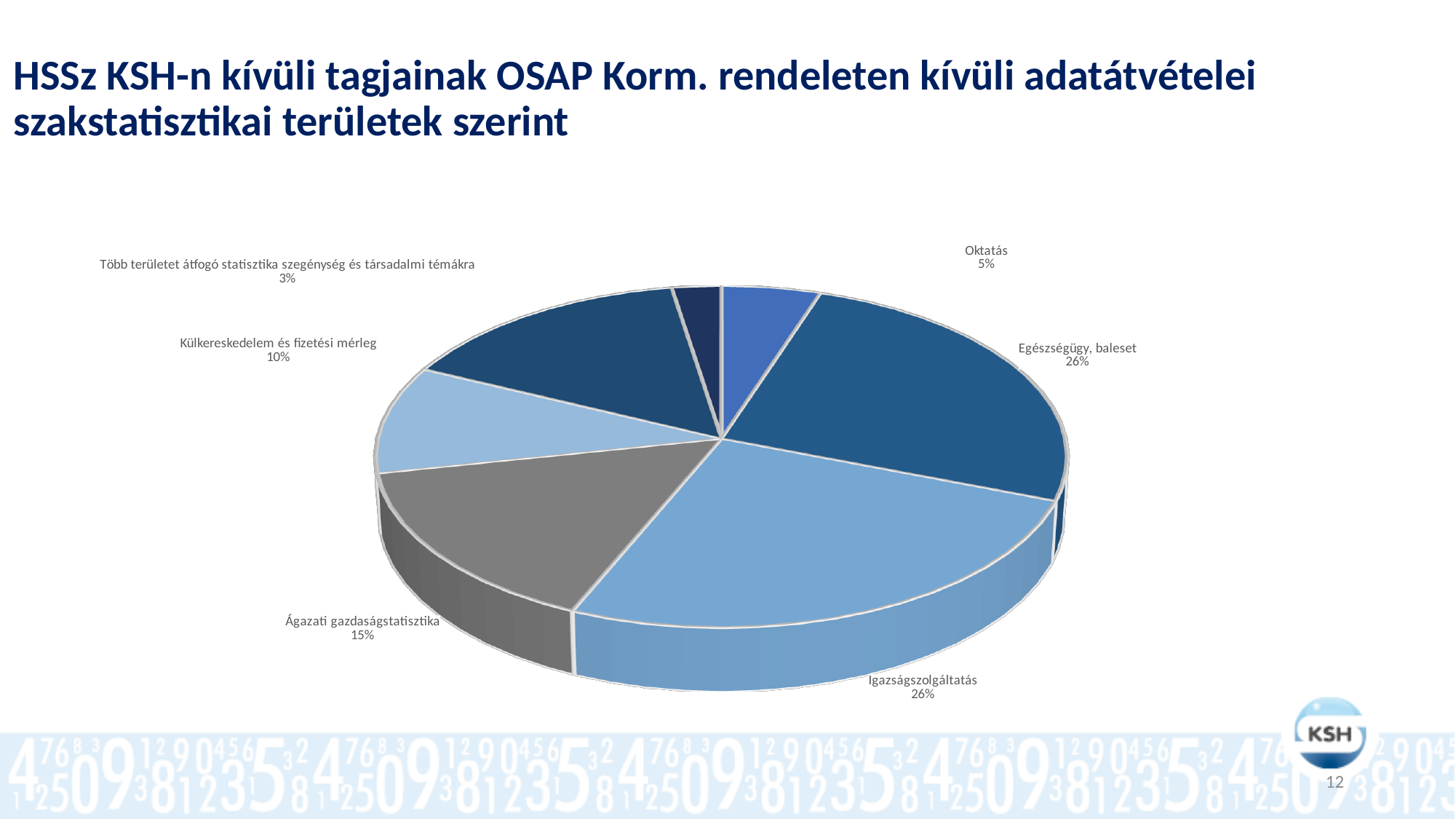
What percentage is shown for Igazságszolgáltatás? 26% What percentage is shown for Külkereskedelem és fizetési mérleg? 10% What is the title of the slide containing the pie chart? HSSz KSH-n kívüli tagjainak OSAP Korm. rendeleten kívüli adatátvételei szakstatisztikai területek szerint What share of the pie does Oktatás represent? 5% What kind of chart is shown on the slide? pie chart Which labelled category has the smallest share of the pie? Több területet átfogó statisztika szegénység és társadalmi témákra How many slices does the pie chart have? 7 What percentage is shown for Egészségügy, baleset? 26% Which is larger, the share for Ágazati gazdaságstatisztika or the share for Külkereskedelem és fizetési mérleg? Ágazati gazdaságstatisztika What percentage is shown for Ágazati gazdaságstatisztika? 15% What is the difference in percentage points between Egészségügy, baleset and Oktatás? 21 What is the difference in percentage points between Ágazati gazdaságstatisztika and Külkereskedelem és fizetési mérleg? 5